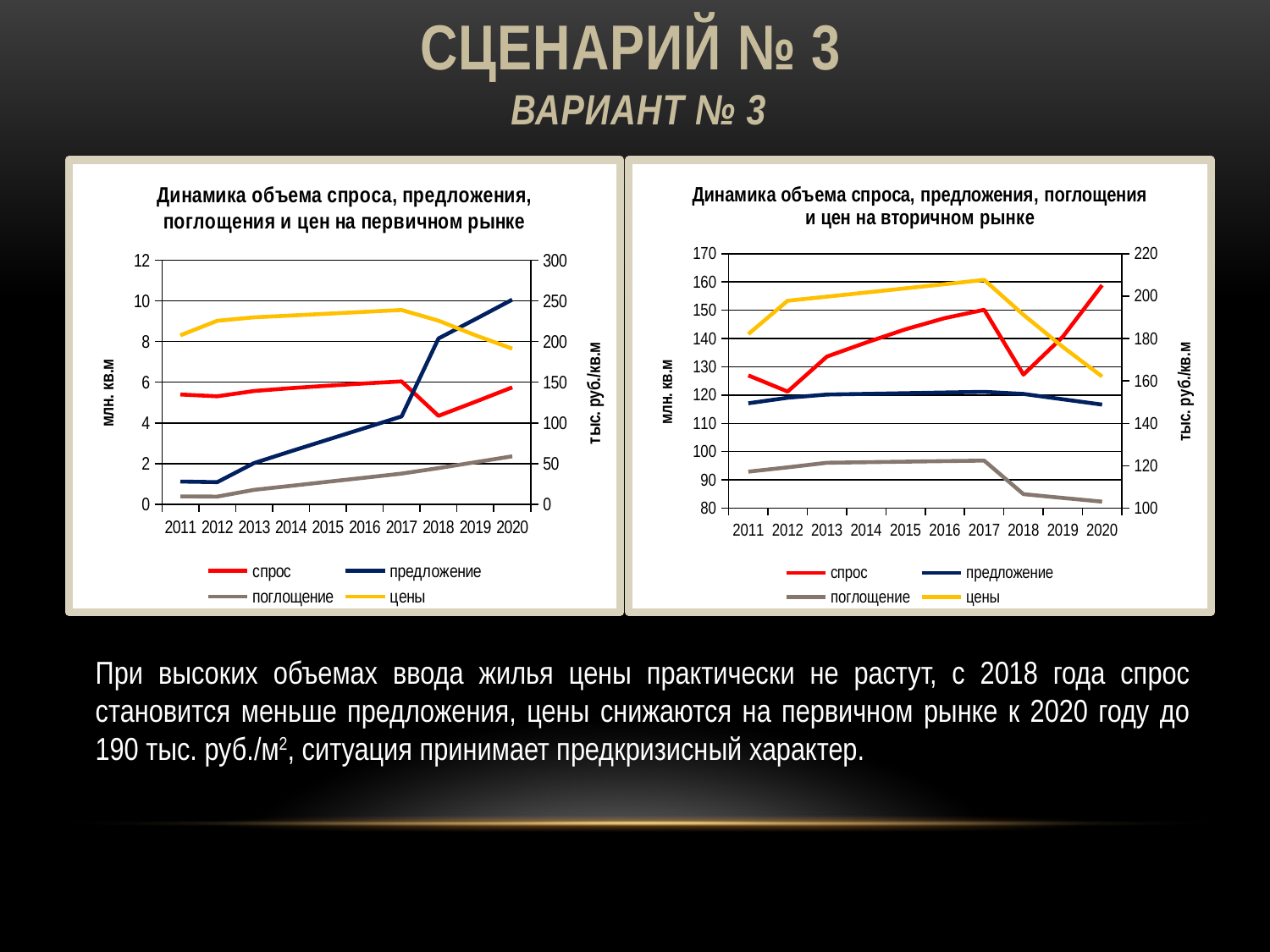
What is the label of the right-hand vertical axis of the left chart ('...на первичном рынке')? тыс. руб./кв.м In the right chart ('...на вторичном рынке'), does the 'цены' line rise or fall from 2017 to 2020? falls In the left chart ('...на первичном рынке'), which is larger in 2020: 'спрос' or 'предложение'? предложение In the left chart ('...на первичном рынке'), is the value for 'спрос' in 2011 greater or less than 4? greater What kind of chart is the left chart, 'Динамика объема спроса, предложения, поглощения и цен на первичном рынке'? line chart In the right chart ('...на вторичном рынке'), which is larger in 2020: 'спрос' or 'предложение'? спрос How many years are plotted along the x axis of the left chart ('...на первичном рынке')? 10 In the right chart ('...на вторичном рынке'), in which year is 'поглощение' lowest? 2020 In the right chart ('...на вторичном рынке'), in which year is 'цены' highest? 2017 In the left chart ('...на первичном рынке'), does the 'предложение' line rise or fall from 2011 to 2020? rises In the left chart ('...на первичном рынке'), is the value for 'предложение' in 2020 greater or less than 8? greater How many series does the legend of the right chart ('...на вторичном рынке') list? 4